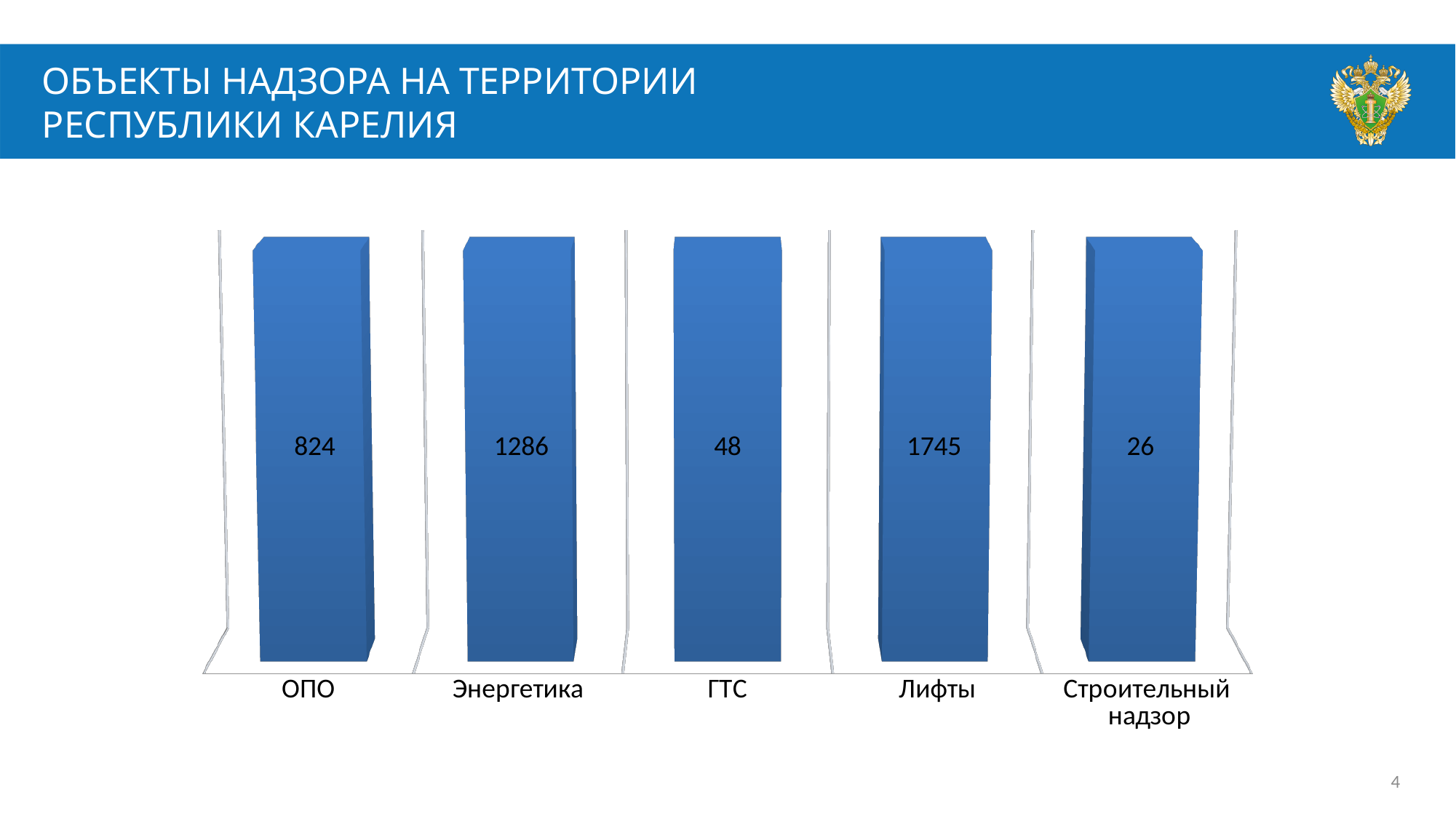
What is the difference between the values for ГТС and Строительный надзор? 22 Which category has the highest value? Лифты How many categories are shown in the chart? 5 Which category has the lowest value? Строительный надзор What is the value for Энергетика? 1286 What is the difference between the values for Лифты and Энергетика? 459 What is the value for Строительный надзор? 26 What kind of chart is shown on the slide? Bar chart Which is larger, the value for ОПО or the value for Энергетика? Энергетика What is the value for ОПО? 824 What is the value for Лифты? 1745 What is the value for ГТС? 48